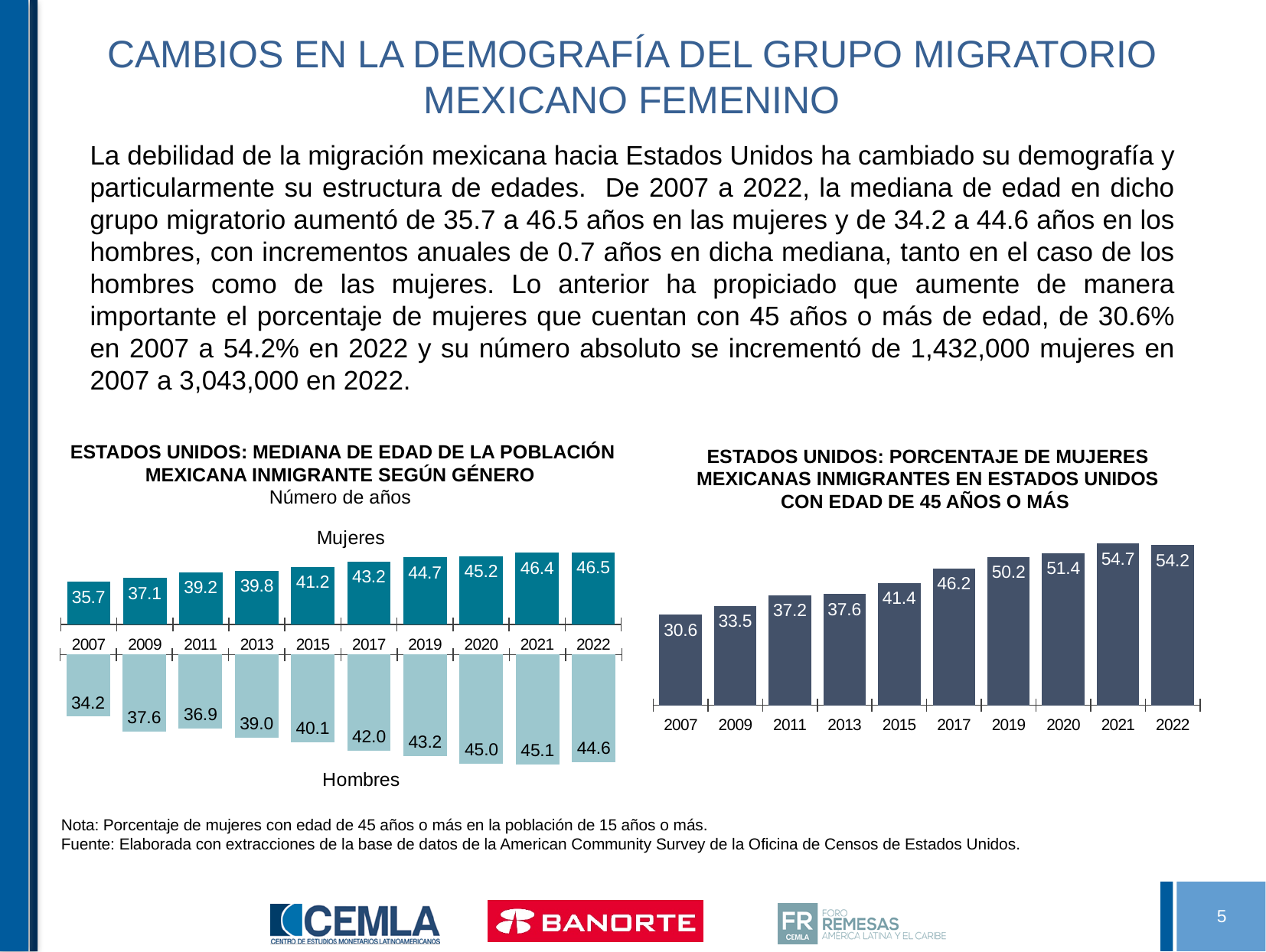
In the right chart (percentage of women aged 45 or more), what is the value for 2015? 41.4 What kind of chart is the right chart (percentage of women aged 45 or more)? Bar chart In the left chart (median age by gender), which is larger in 2009: the median age for Mujeres or for Hombres? Hombres In the right chart (percentage of women aged 45 or more), which year has the highest value? 2021 In the left chart (median age by gender), how many series are plotted? 2 In the left chart (median age by gender), what is the median age for Hombres in 2022? 44.6 In the left chart (median age by gender), which year has the highest median age for Mujeres? 2022 In the right chart (percentage of women aged 45 or more), what is the difference between the 2022 value and the 2007 value? 23.6 In the left chart (median age by gender), which year has the lowest median age for Hombres? 2007 In the left chart (median age by gender), what is the difference between the Mujeres median age in 2022 and in 2007? 10.8 In the left chart (median age by gender), how many years are shown on the x axis? 10 In the left chart (median age by gender), what is the median age for Mujeres in 2007? 35.7